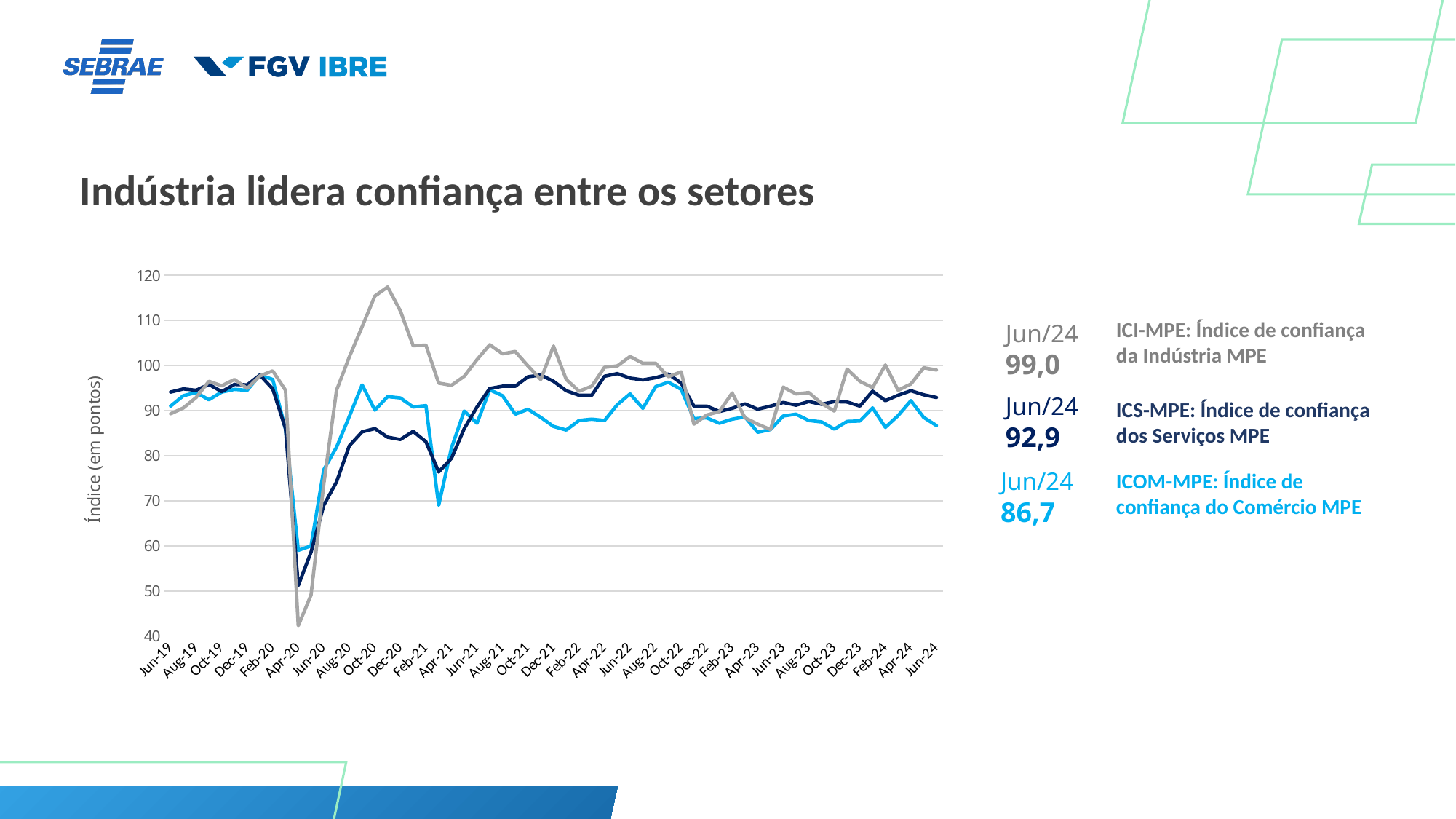
What is the difference between the ICI-MPE and ICOM-MPE values in Jun/24? 12,3 What is the value of ICS-MPE (Índice de confiança dos Serviços MPE) in Jun/24? 92,9 What is the difference between the ICI-MPE and ICS-MPE values in Jun/24? 6,1 Which index has the highest value in Jun/24? ICI-MPE Is the peak of the ICI-MPE (grey line) around Dec-20 greater or less than 110? greater Which index has the lowest value in Jun/24? ICOM-MPE Is the value of ICI-MPE (grey line) in Apr-20 greater or less than 50? less What kind of chart is shown on the slide? Line chart What is the value of ICOM-MPE (Índice de confiança do Comércio MPE) in Jun/24? 86,7 What is the value of ICI-MPE (Índice de confiança da Indústria MPE) in Jun/24? 99,0 How many series are shown in the chart? 3 In Jun/24, which is larger: ICS-MPE or ICOM-MPE? ICS-MPE